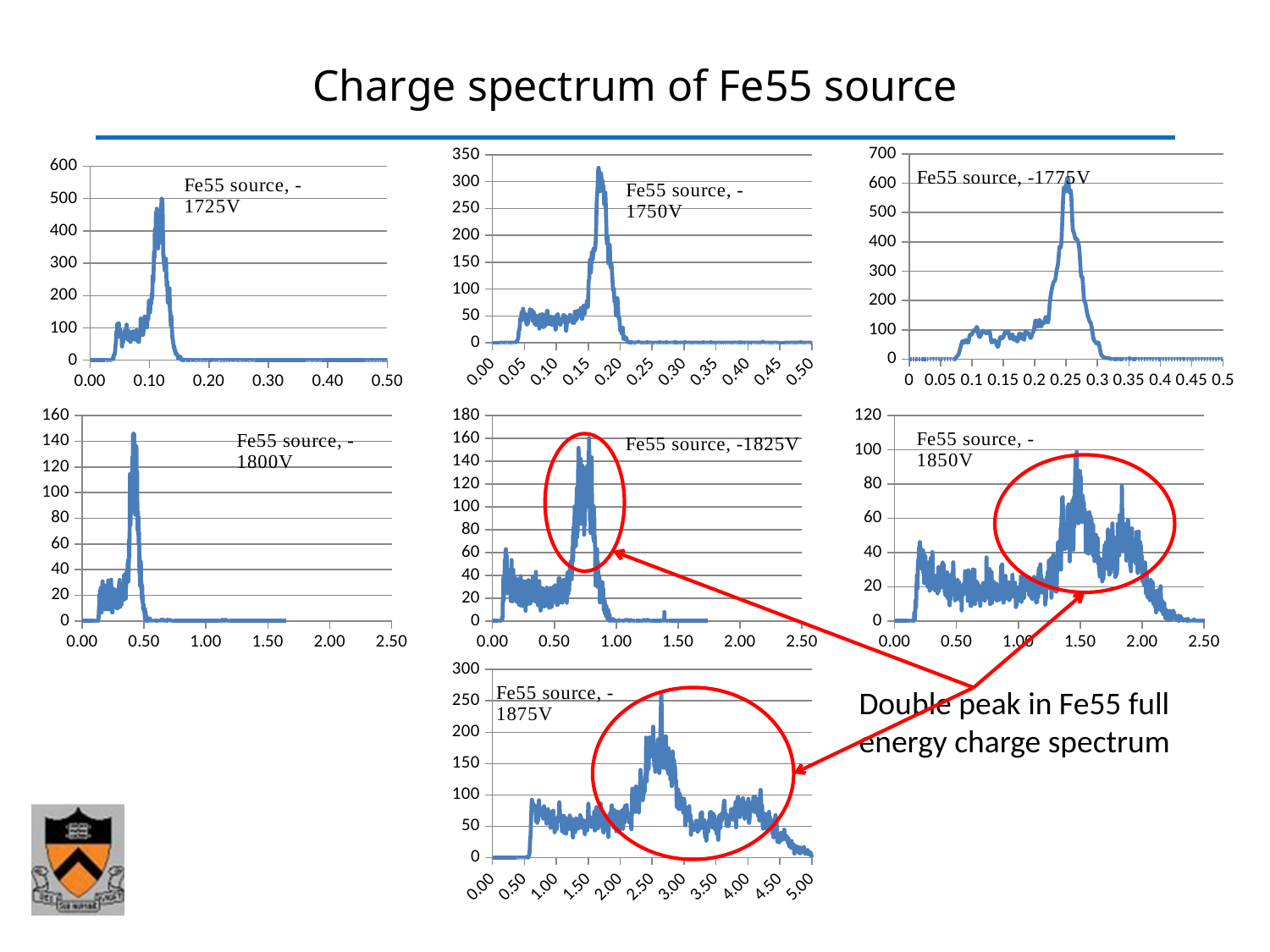
In the 'Fe55 source, -1800V' chart, is the peak value greater or less than 120? greater In the 'Fe55 source, -1850V' chart, is the peak value greater or less than 80? greater In the 'Fe55 source, -1750V' chart, is the peak value greater or less than 300? greater How many charge spectrum charts are shown on the slide? 7 Which charts on the slide have a red circle drawn around part of the spectrum? Fe55 source, -1825V; Fe55 source, -1850V; Fe55 source, -1875V What does the red text annotation on the slide say about the circled regions? Double peak in Fe55 full energy charge spectrum What kind of chart is the 'Fe55 source, -1725V' chart? line chart